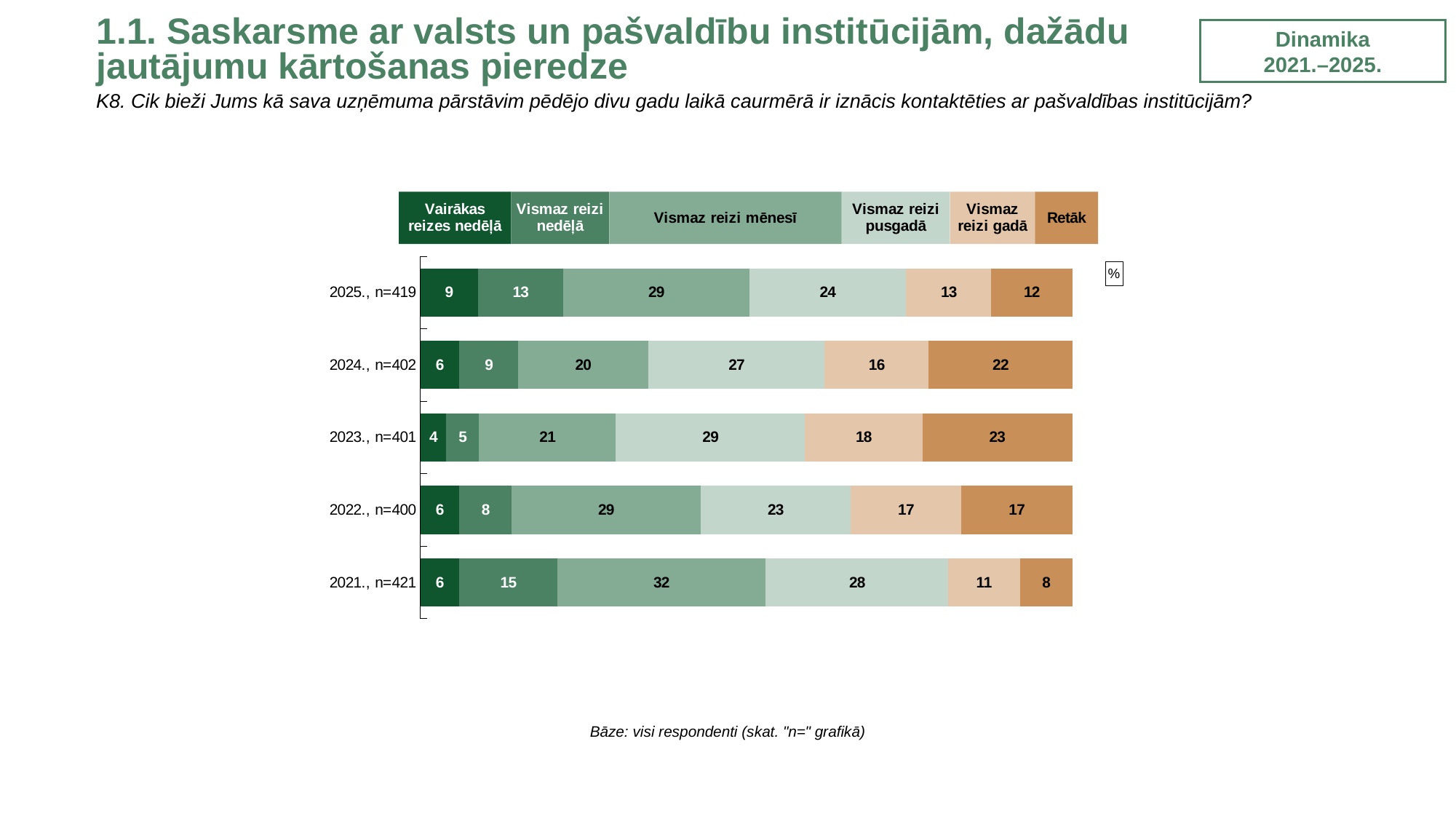
What is the value for "Vairākas reizes nedēļā" in the 2023., n=401 bar? 4 What is the value for "Vismaz reizi mēnesī" in the 2025., n=419 bar? 29 Which year has the lowest value for "Vismaz reizi nedēļā"? 2023., n=401 Which year has the highest value for "Retāk"? 2023., n=401 What is the difference between the "Retāk" values for 2024., n=402 and 2025., n=419? 10 What is the value for "Retāk" in the 2021., n=421 bar? 8 How many series does the legend list? 6 What kind of chart is shown on the slide? Stacked bar chart What is the total of the 2025., n=419 stacked bar? 100 Which year has the larger value for "Vismaz reizi mēnesī": 2021., n=421 or 2022., n=400? 2021., n=421 How many bars (years) are shown in the chart? 5 What is the first entry in the chart's legend? Vairākas reizes nedēļā